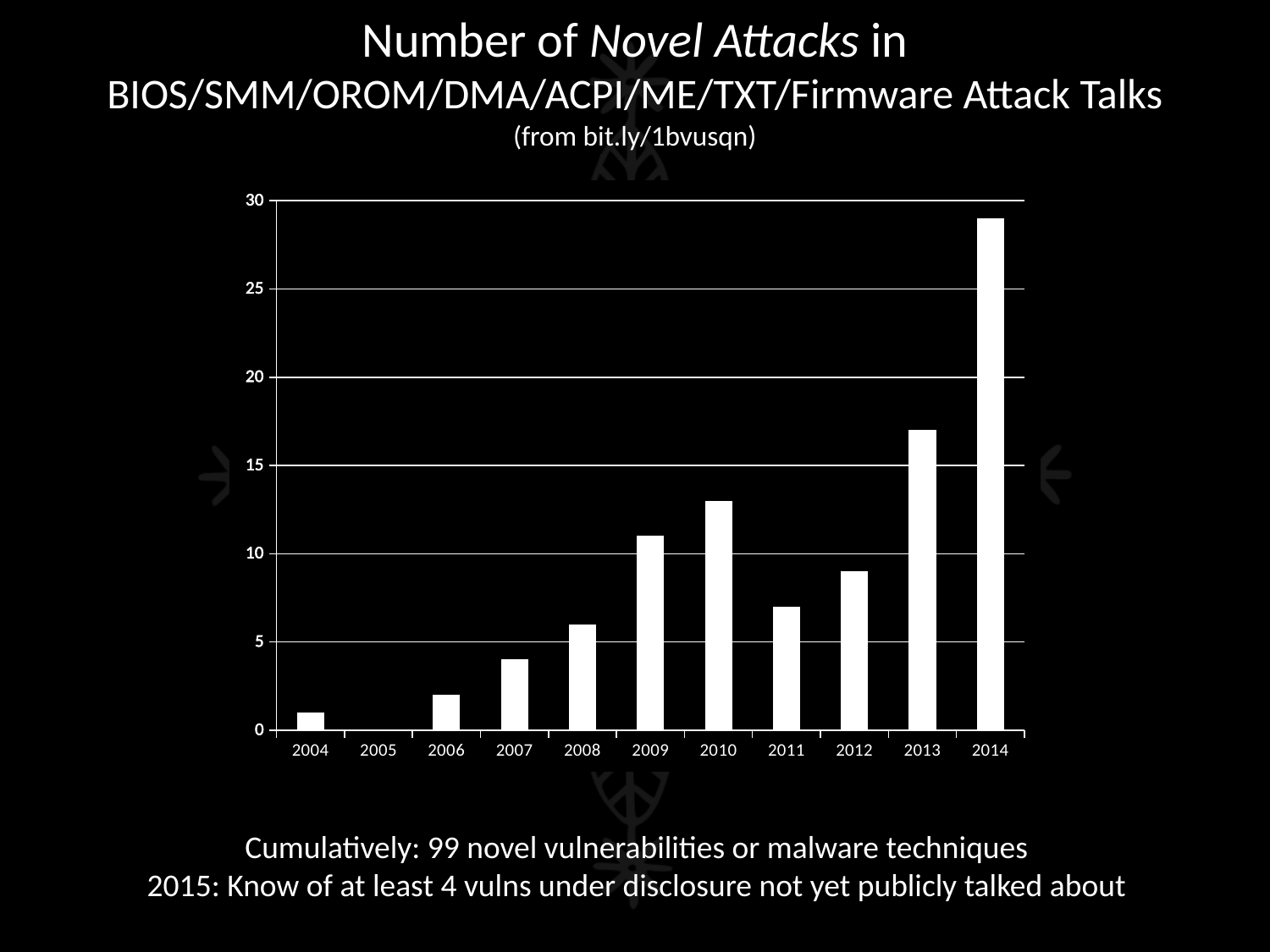
Which year has the highest number of novel attacks? 2014 What is the value for 2005? 0 Do the values generally rise or fall from 2004 to 2014? rise Which is larger, the value for 2010 or the value for 2013? 2013 Is the value for 2011 greater or less than 10? less Which year has the lowest number of novel attacks? 2005 Is the value for 2014 greater or less than 25? greater Which is larger, the value for 2011 or the value for 2012? 2012 What kind of chart is shown on the slide? bar chart How many years are shown on the x axis of the chart? 11 Is the value for 2008 greater or less than 5? greater